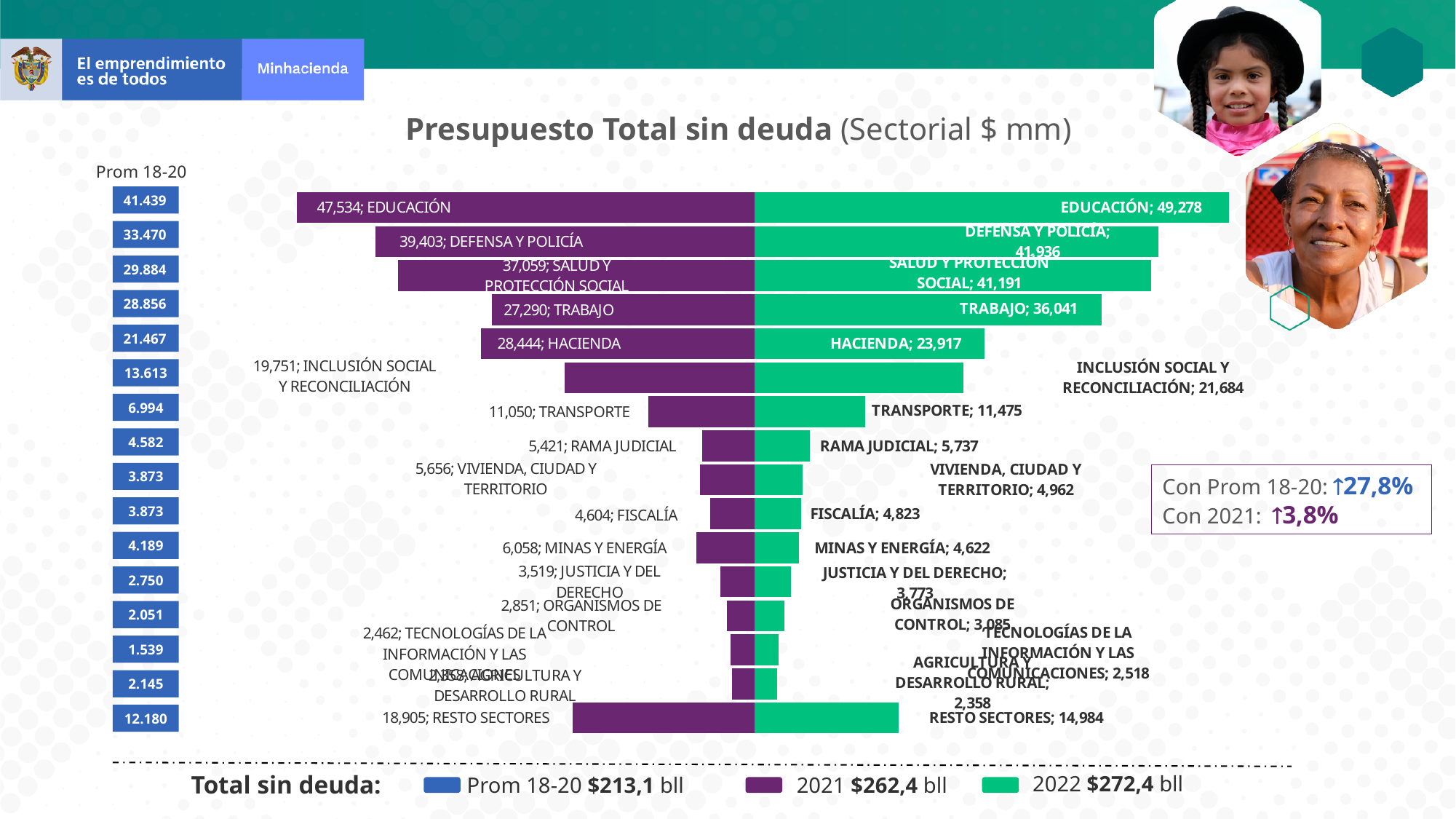
What is the difference between the 2022 and 2021 values for TRABAJO? 8,751 Which sector has the highest 2022 value? EDUCACIÓN What is the 2021 value for RESTO SECTORES? 18,905 What is the 2022 value for EDUCACIÓN? 49,278 How many series does the legend at the bottom of the slide list? 3 Which colour represents the 2022 series in the chart? Green What is the 2022 value for HACIENDA? 23,917 What is the difference between the 2022 and 2021 values for EDUCACIÓN? 1,744 For HACIENDA, which is larger, the 2021 value or the 2022 value? 2021 What is the 2022 value for TRANSPORTE? 11,475 What is the 2021 value for TRABAJO? 27,290 What kind of chart is shown on the slide? Bar chart